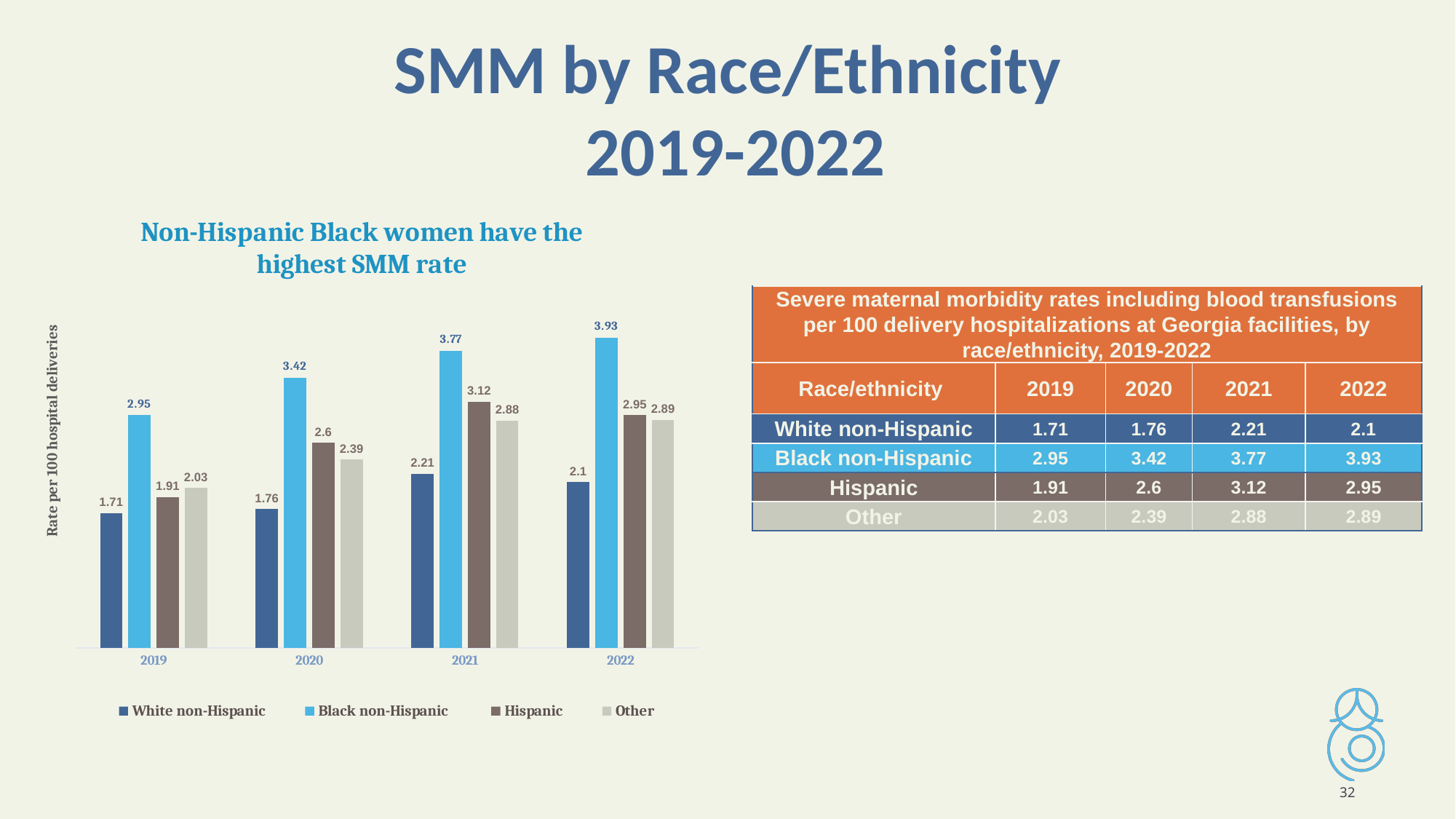
What is the SMM rate for the Other group in 2020? 2.39 What is the difference between the Black non-Hispanic and White non-Hispanic SMM rates in 2020? 1.66 What kind of chart is shown on the slide? Bar chart Which is larger in 2019: the SMM rate for Hispanic women or for the Other group? Other How many years are shown on the x axis of the chart? 4 How many series does the chart legend list? 4 Which race/ethnicity group has the lowest SMM rate in 2022? White non-Hispanic What is the SMM rate for Hispanic women in 2021? 3.12 Does the SMM rate for Black non-Hispanic women rise or fall from 2019 to 2022? Rise What is the SMM rate for White non-Hispanic women in 2019? 1.71 Which race/ethnicity group has the highest SMM rate in 2021? Black non-Hispanic What is the SMM rate for Black non-Hispanic women in 2022? 3.93